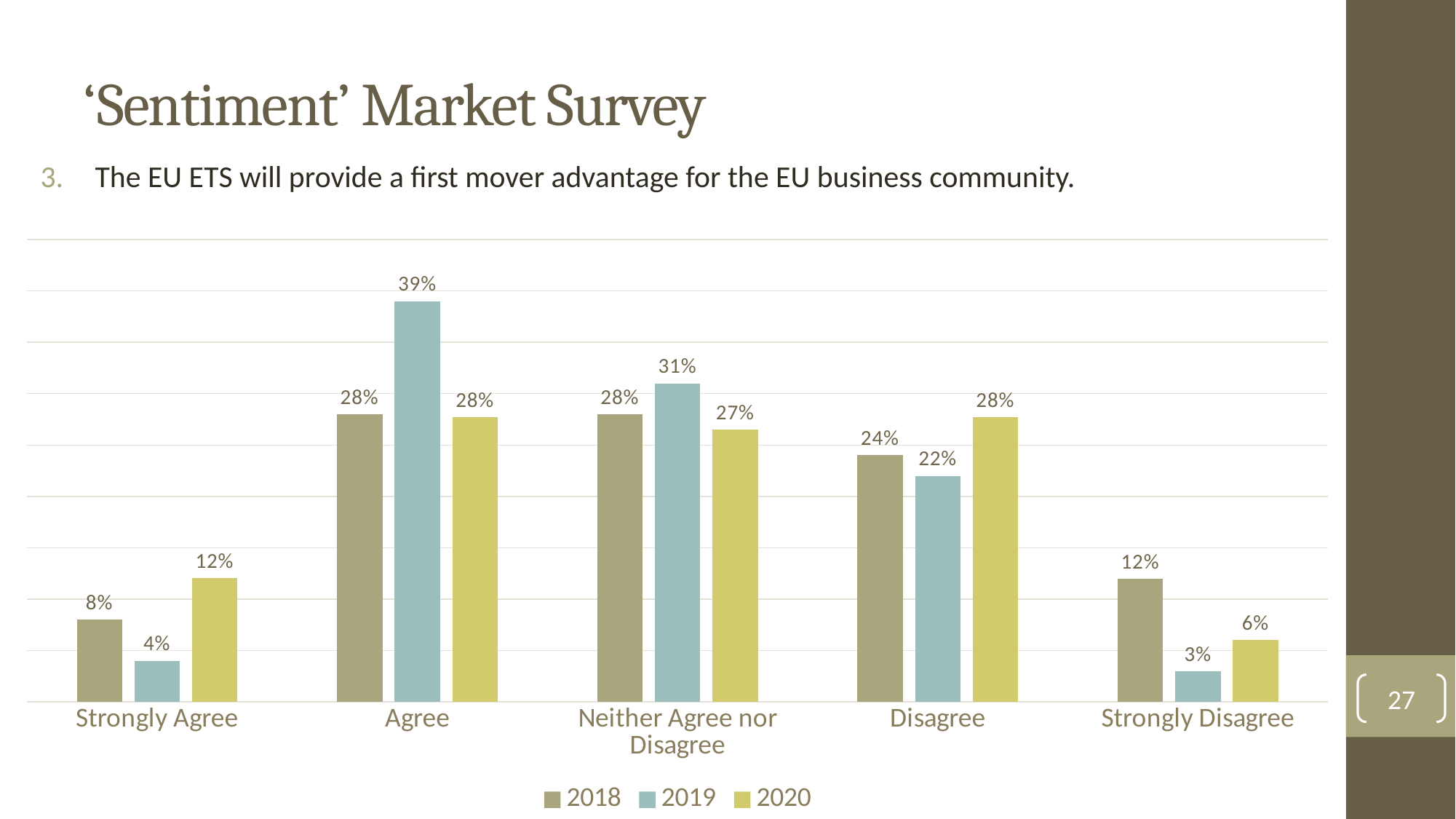
How many series does the legend list? 3 How many categories are shown on the x axis? 5 What is the value for Disagree in the 2020 series? 28% What is the value for Strongly Disagree in the 2018 series? 12% What is the value for Agree in the 2019 series? 39% What is the difference between the 2019 and 2018 values for Agree? 11% Which series is shown in blue-grey in the legend? 2019 What kind of chart is shown on the slide? Bar chart What is the difference between the 2020 and 2019 values for Strongly Agree? 8% Which is larger for Disagree: the 2018 value or the 2019 value? 2018 Which category has the lowest value in the 2020 series? Strongly Disagree Which category has the highest value in the 2019 series? Agree